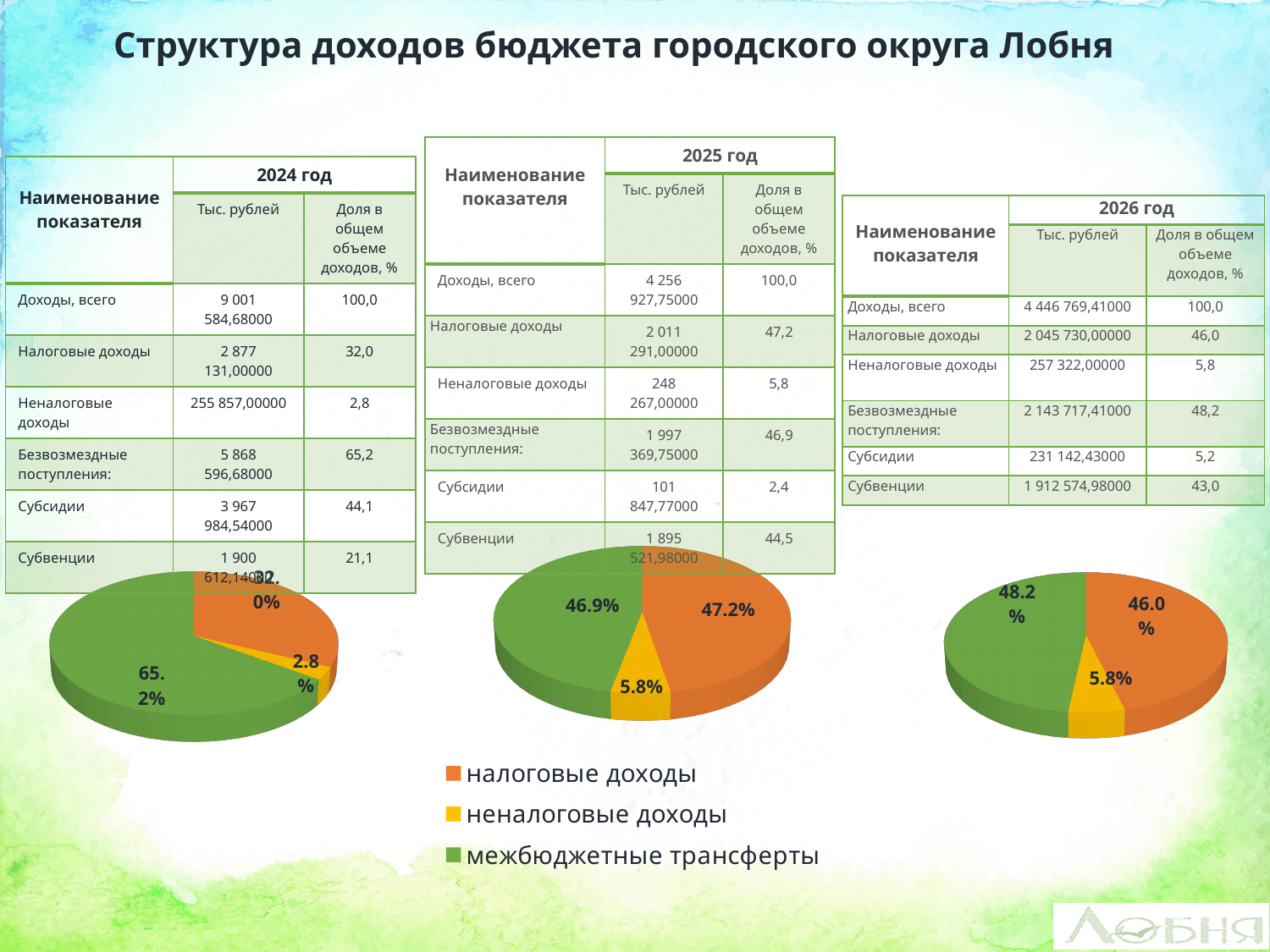
In the left pie chart, what is the share of the yellow slice (неналоговые доходы)? 2.8% In the middle pie chart, what is the difference between the shares of налоговые доходы and межбюджетные трансферты? 0.3% In the right pie chart, which is larger: the share of налоговые доходы or the share of межбюджетные трансферты? межбюджетные трансферты Which colour represents неналоговые доходы in the pie charts? yellow How many entries does the shared legend below the pie charts list? 3 In the right pie chart, what is the share of the orange slice (налоговые доходы)? 46.0% In the right pie chart, which slice is the smallest? неналоговые доходы In the right pie chart, what is the share of the green slice (межбюджетные трансферты)? 48.2% What kind of chart is the left chart on the slide? pie chart In the middle pie chart, what is the share of the orange slice (налоговые доходы)? 47.2% In the middle pie chart, what is the share of the green slice (межбюджетные трансферты)? 46.9% In the left pie chart, which slice is the largest? межбюджетные трансферты